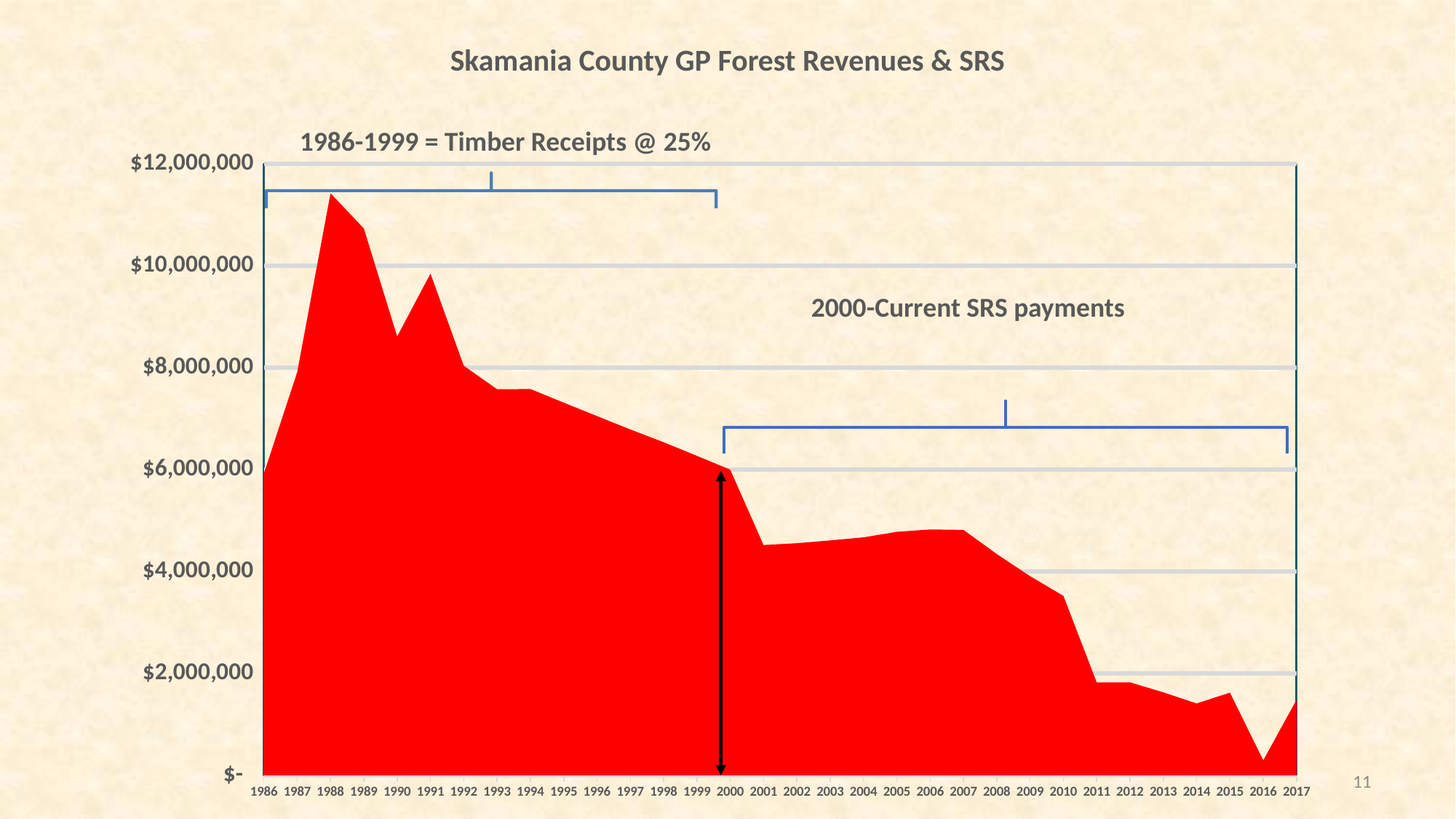
What type of chart is shown on the slide? Area chart What is the title of the chart? Skamania County GP Forest Revenues & SRS According to the annotation on the chart, what do the values for 1986-1999 represent? Timber Receipts @ 25% Is the value for 2017 greater or less than $2,000,000? less How many years are plotted along the x axis of the chart? 32 Which year has the highest value in the chart? 1988 Which year has the lowest value in the chart? 2016 Do the values generally rise or fall from 2007 to 2016? fall Is the value for 1989 greater or less than $10,000,000? greater Is the value for 1996 greater or less than $6,000,000? greater Which year has the larger value, 1988 or 1991? 1988